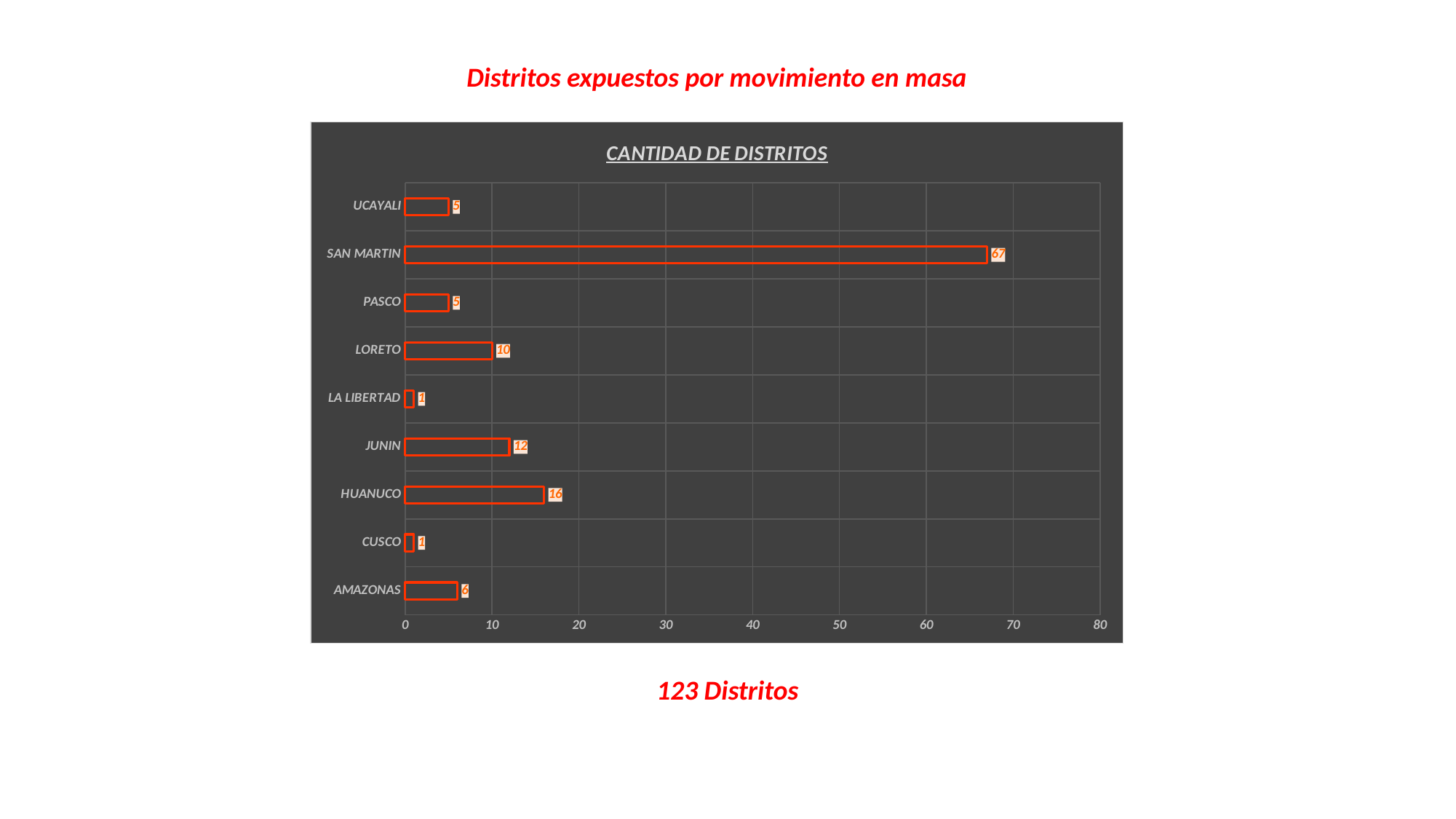
What is the value for HUANUCO? 16 How many categories are shown on the chart? 9 Which is larger, the value for JUNIN or the value for LORETO? JUNIN What is the value for SAN MARTIN? 67 What is the value for UCAYALI? 5 What kind of chart is shown on the slide? bar chart Which category has the highest value? SAN MARTIN What is the difference between the values for SAN MARTIN and HUANUCO? 51 What is the difference between the values for JUNIN and AMAZONAS? 6 What is the value for LORETO? 10 Is the value for SAN MARTIN greater or less than 60? greater What is the title of the chart? CANTIDAD DE DISTRITOS